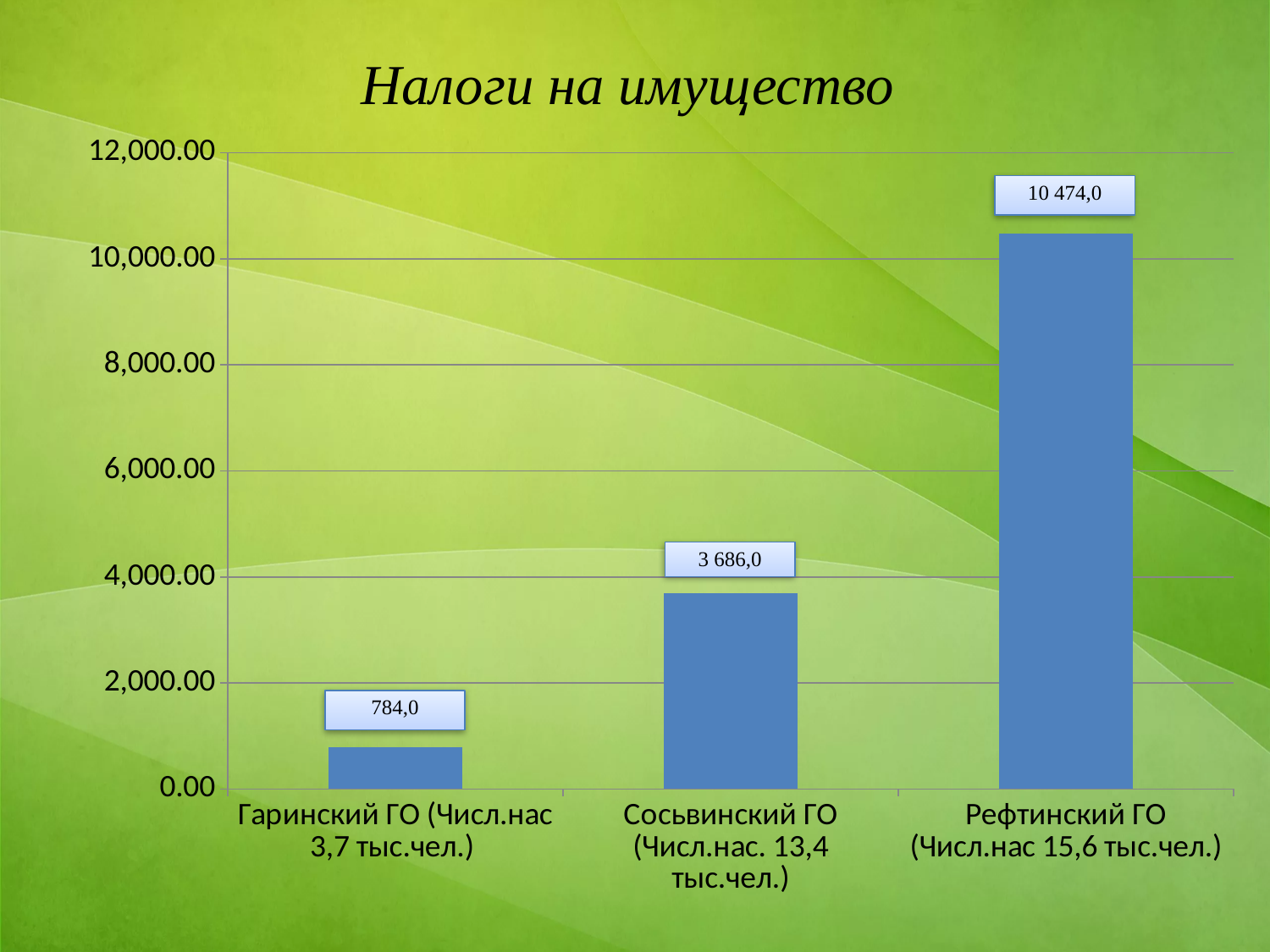
What kind of chart is shown on the slide? bar chart How many categories are shown on the chart? 3 What is the title of the chart? Налоги на имущество What is the value for Сосьвинский ГО? 3 686,0 Which is larger, the value for Сосьвинский ГО or the value for Гаринский ГО? Сосьвинский ГО What is the difference between the values for Рефтинский ГО and Сосьвинский ГО? 6 788,0 What is the difference between the values for Сосьвинский ГО and Гаринский ГО? 2 902,0 Which category has the lowest value? Гаринский ГО Is the value for Рефтинский ГО greater or less than 10,000.00? greater What is the value for Рефтинский ГО? 10 474,0 What is the value for Гаринский ГО? 784,0 Which category has the highest value? Рефтинский ГО